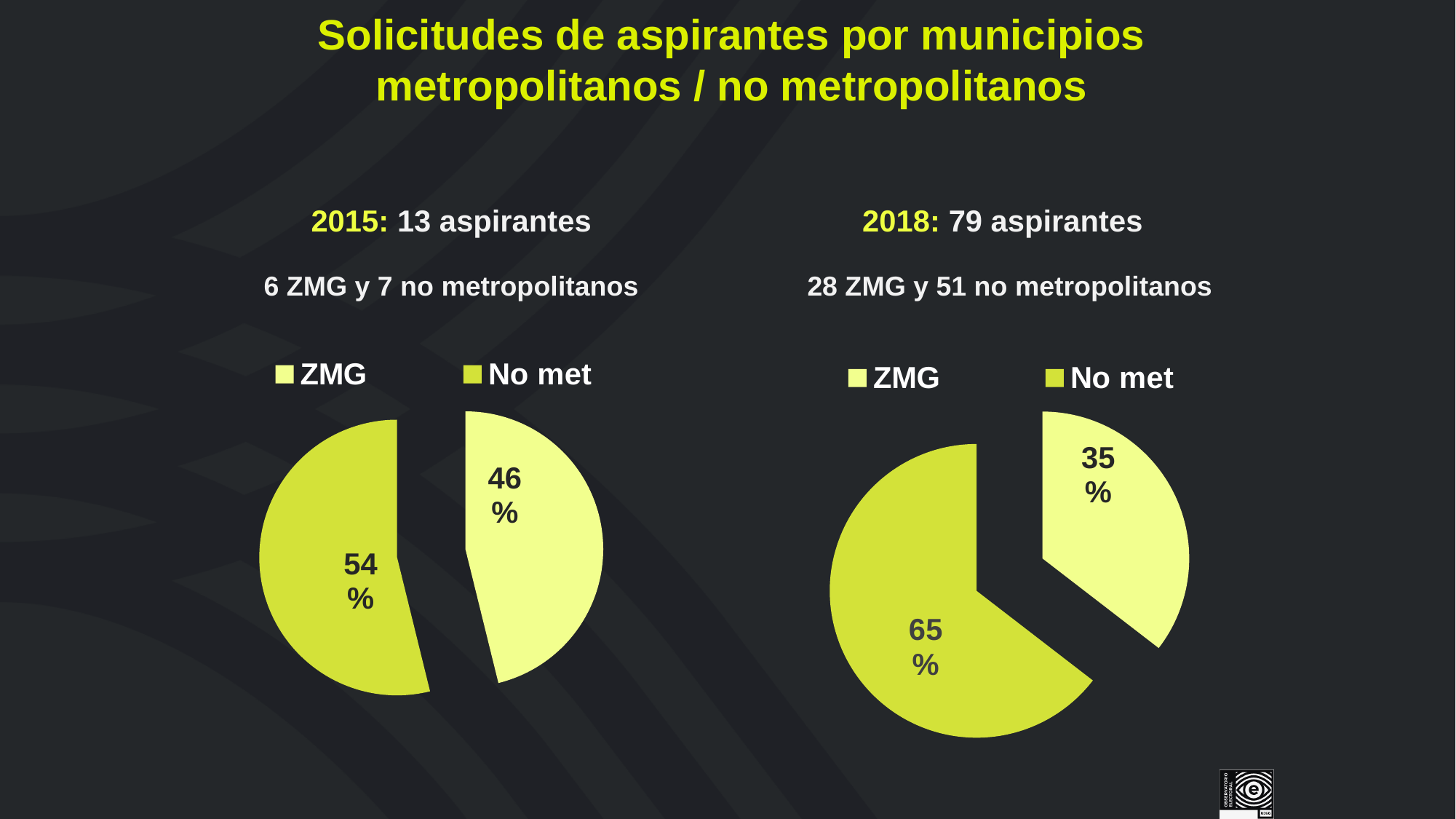
In the 2015 pie chart, what share is labelled for ZMG? 46% In the 2015 pie chart, what is the difference in percentage points between No met and ZMG? 8 In the 2015 pie chart, what share is labelled for No met? 54% In the 2018 pie chart, what share is labelled for No met? 65% In the 2018 pie chart, what is the difference in percentage points between No met and ZMG? 30 In the 2018 pie chart, which slice is the largest? No met How many slices does the 2018 pie chart have? 2 How many entries does the legend of the 2015 chart list? 2 In the 2015 pie chart, which slice is the smallest? ZMG Is the ZMG share larger in the 2015 pie chart or the 2018 pie chart? 2015 What type of chart is used for the 2015 data? Pie chart In the 2018 pie chart, what share is labelled for ZMG? 35%